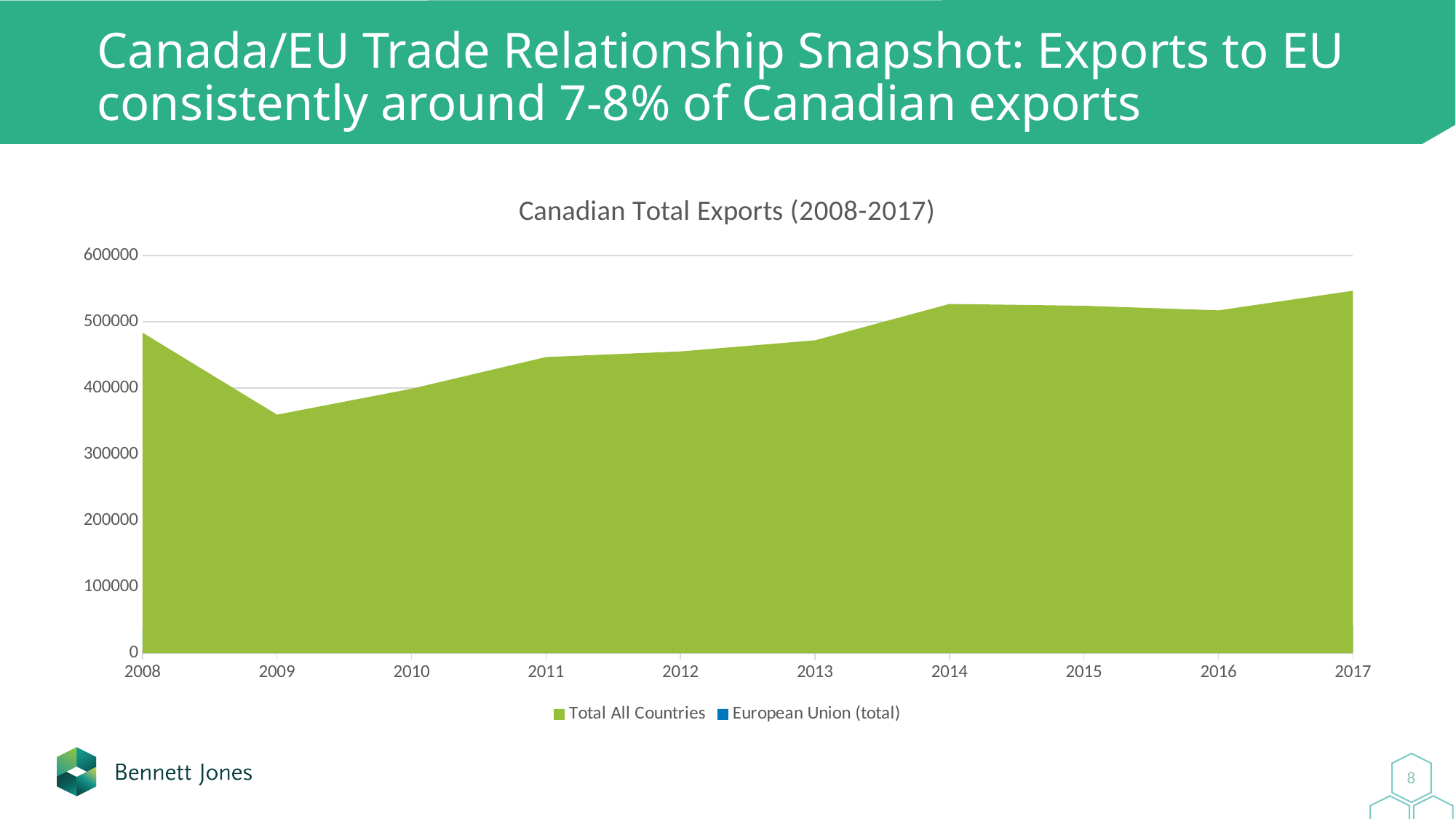
Is the Total All Countries value for 2009 greater or less than 400000? less Does the Total All Countries value rise or fall from 2009 to 2014? rise Which series is shown in green in the legend? Total All Countries What kind of chart is shown on the slide? Area chart Is the Total All Countries value for 2014 greater or less than 500000? greater Which year has the larger Total All Countries value, 2008 or 2009? 2008 How many series does the chart's legend list? 2 In which year is the Total All Countries value highest? 2017 What is the title of the chart? Canadian Total Exports (2008-2017) How many years are plotted along the x axis of the chart? 10 In which year is the Total All Countries value lowest? 2009 Is the Total All Countries value for 2011 greater or less than 500000? less